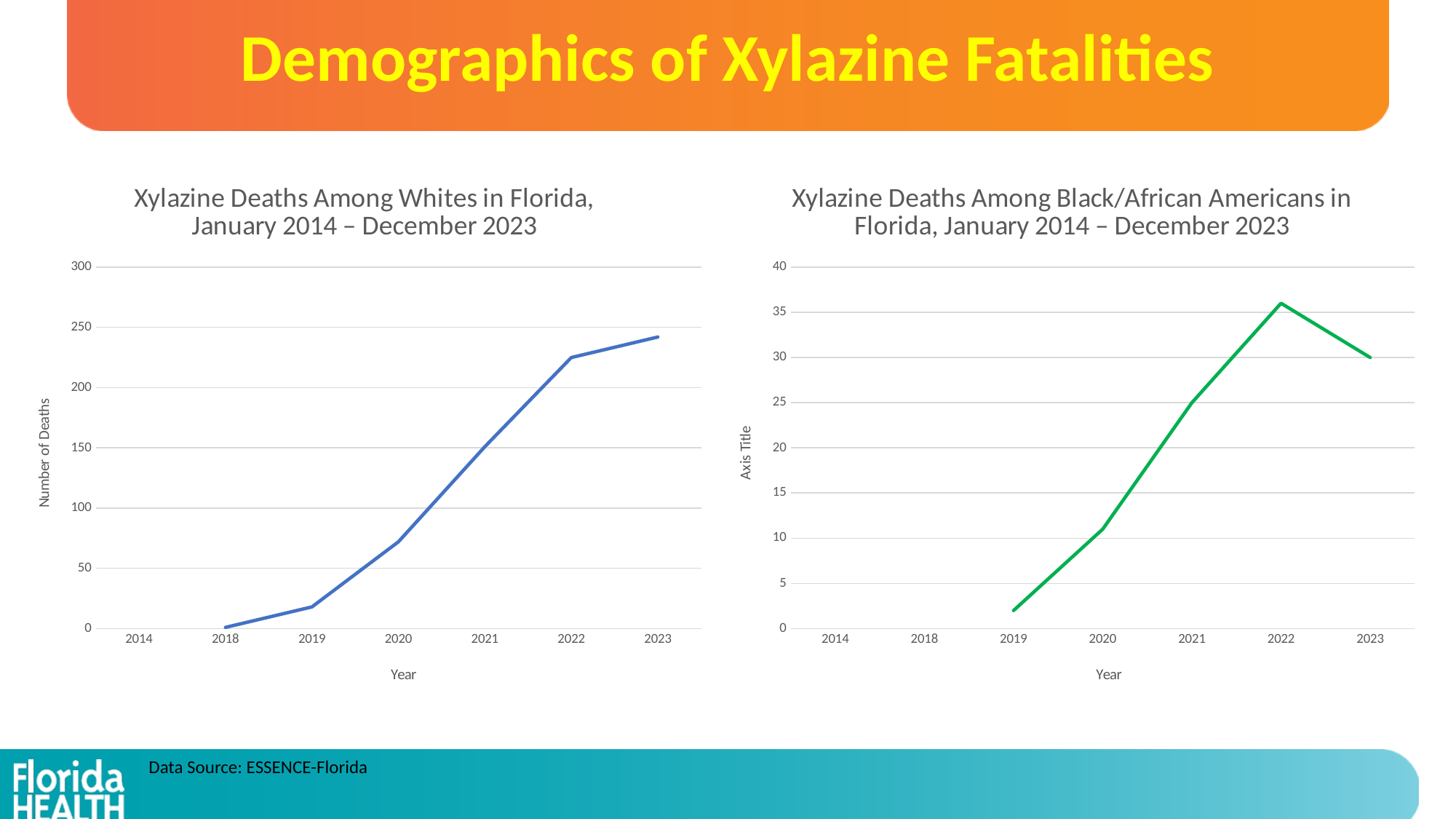
In the right chart (Xylazine Deaths Among Black/African Americans in Florida), which plotted year has the lowest value? 2019 In the left chart (Xylazine Deaths Among Whites in Florida), is the value for 2023 greater or less than 200? greater What is the y-axis title of the left chart (Xylazine Deaths Among Whites in Florida)? Number of Deaths What kind of chart is the 'Xylazine Deaths Among Whites in Florida' chart on the left? Line chart In the left chart (Xylazine Deaths Among Whites in Florida), is the value for 2020 greater or less than 100? less In the right chart (Xylazine Deaths Among Black/African Americans in Florida), is the value for 2022 greater or less than 30? greater In the right chart (Xylazine Deaths Among Black/African Americans in Florida), do the values rise or fall from 2022 to 2023? Fall In the left chart (Xylazine Deaths Among Whites in Florida), which plotted year has the lowest number of deaths? 2018 In the right chart (Xylazine Deaths Among Black/African Americans in Florida), which year has the larger value, 2022 or 2023? 2022 In the right chart (Xylazine Deaths Among Black/African Americans in Florida), which year has the highest value? 2022 In the left chart (Xylazine Deaths Among Whites in Florida), which year has the highest number of deaths? 2023 In the left chart (Xylazine Deaths Among Whites in Florida), do the values rise or fall from 2018 to 2023? Rise